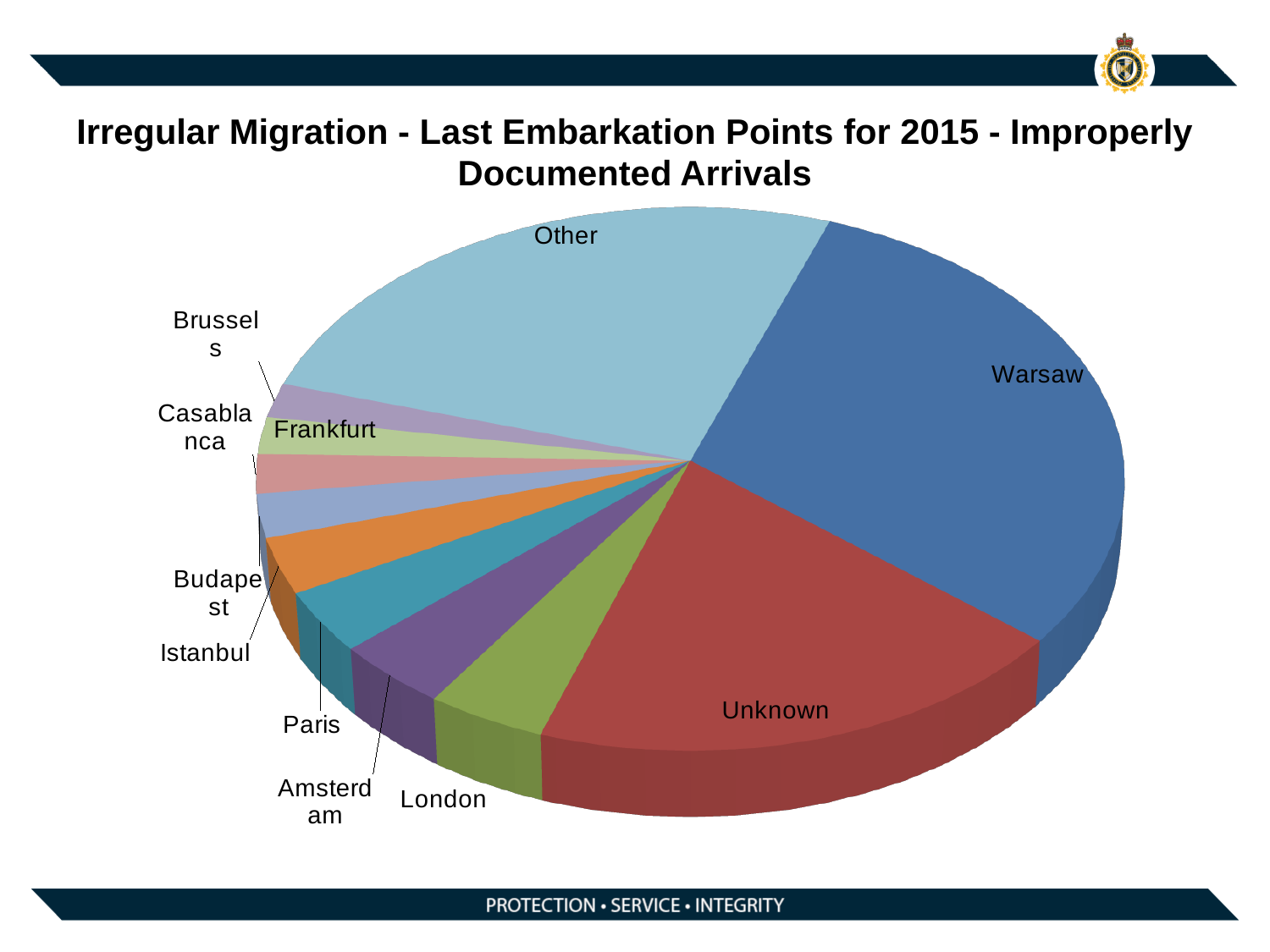
Which slice is larger, Unknown or Paris? Unknown Which slice is larger, Unknown or Budapest? Unknown Which slice is larger, Amsterdam or Frankfurt? Amsterdam Which embarkation point has the largest slice of the pie? Warsaw How many slices does the pie chart have? 11 What is the title of the chart? Irregular Migration - Last Embarkation Points for 2015 - Improperly Documented Arrivals What kind of chart is shown on the slide? pie chart What colour is the Unknown slice? red